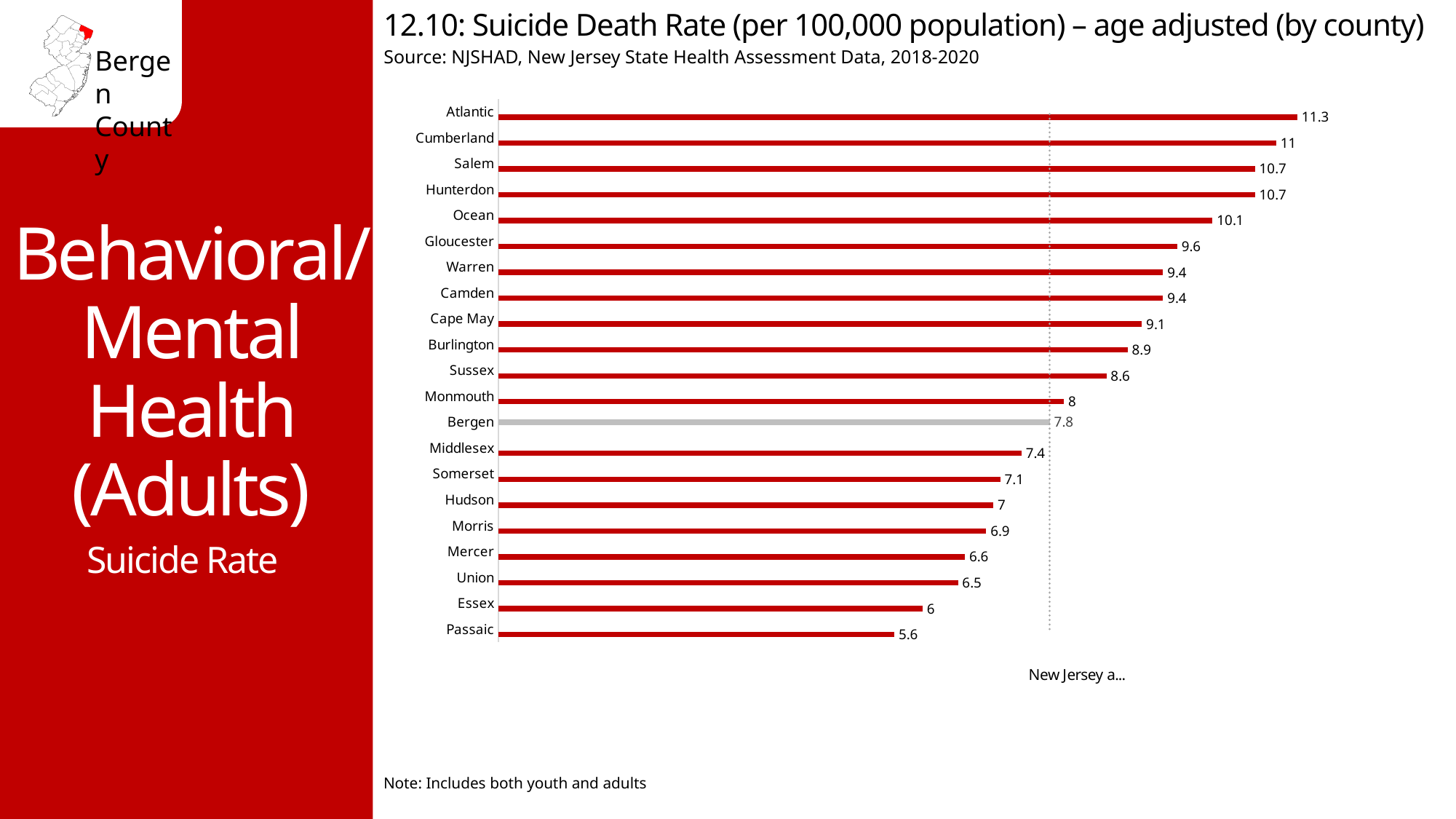
What is the suicide death rate for Bergen County? 7.8 Which county has the highest suicide death rate? Atlantic What is the difference between the suicide death rates of Bergen and Monmouth counties? 0.2 Which county's bar is shown in gray instead of red? Bergen Which county has the lowest suicide death rate? Passaic What is the suicide death rate for Passaic County? 5.6 What type of chart is used to show the suicide death rates by county? Bar chart What is the difference between the suicide death rates of Atlantic and Passaic counties? 5.7 Which county has a higher suicide death rate, Ocean or Gloucester? Ocean How many counties are shown in the chart? 21 Which county has a higher suicide death rate, Hudson or Mercer? Hudson What is the suicide death rate for Atlantic County? 11.3